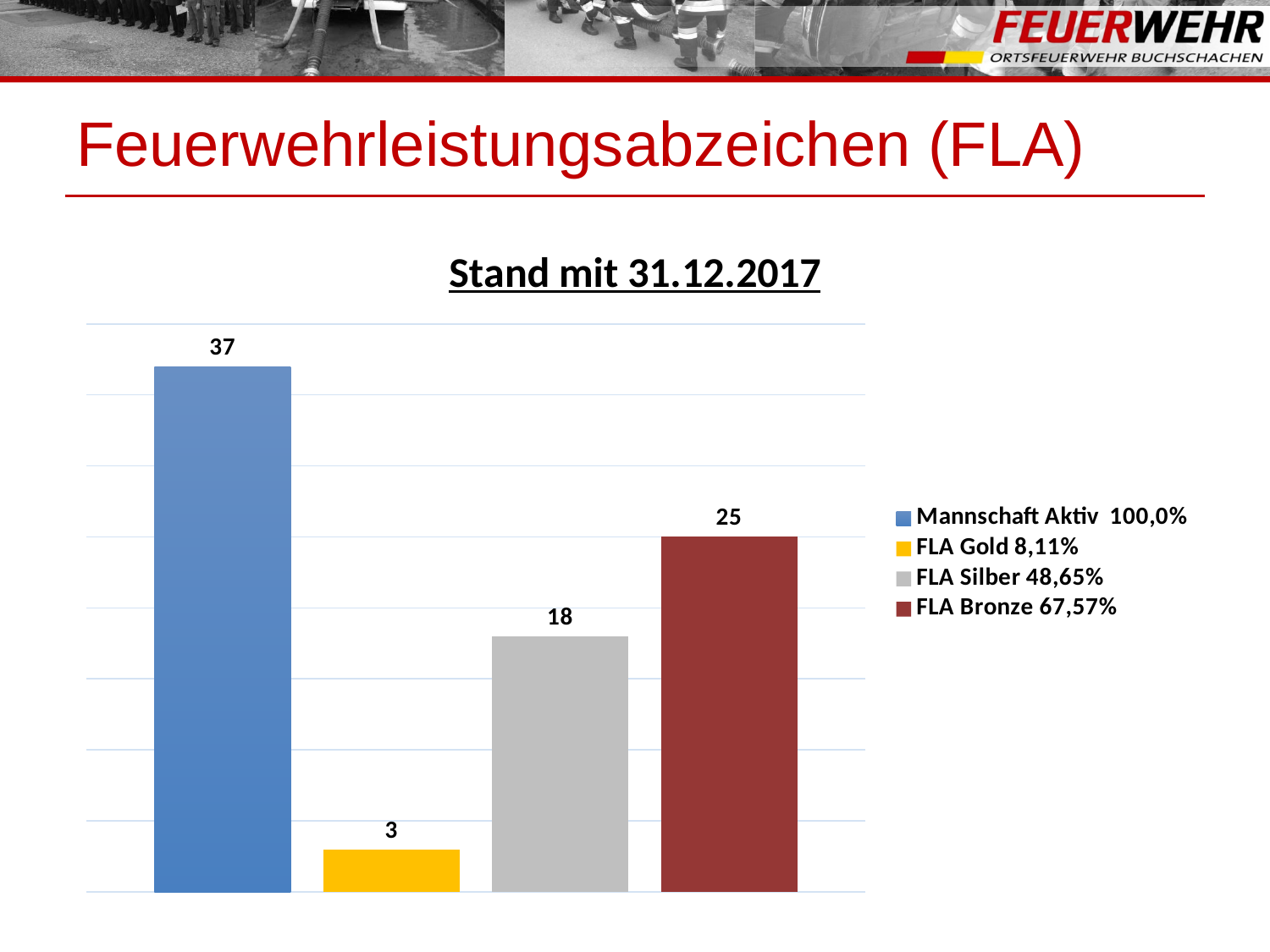
How many bars are shown in the chart? 4 What kind of chart is shown on the slide? Bar chart What is the value for FLA Bronze? 25 What is the value for Mannschaft Aktiv? 37 Which is larger, the value for FLA Silber or the value for FLA Bronze? FLA Bronze Which category has the lowest value? FLA Gold What percentage is shown in the legend for FLA Silber? 48,65% What is the value for FLA Gold? 3 What is the value for FLA Silber? 18 How many entries does the legend list? 4 Which category has the highest value? Mannschaft Aktiv What is the difference between the values for FLA Bronze and FLA Silber? 7